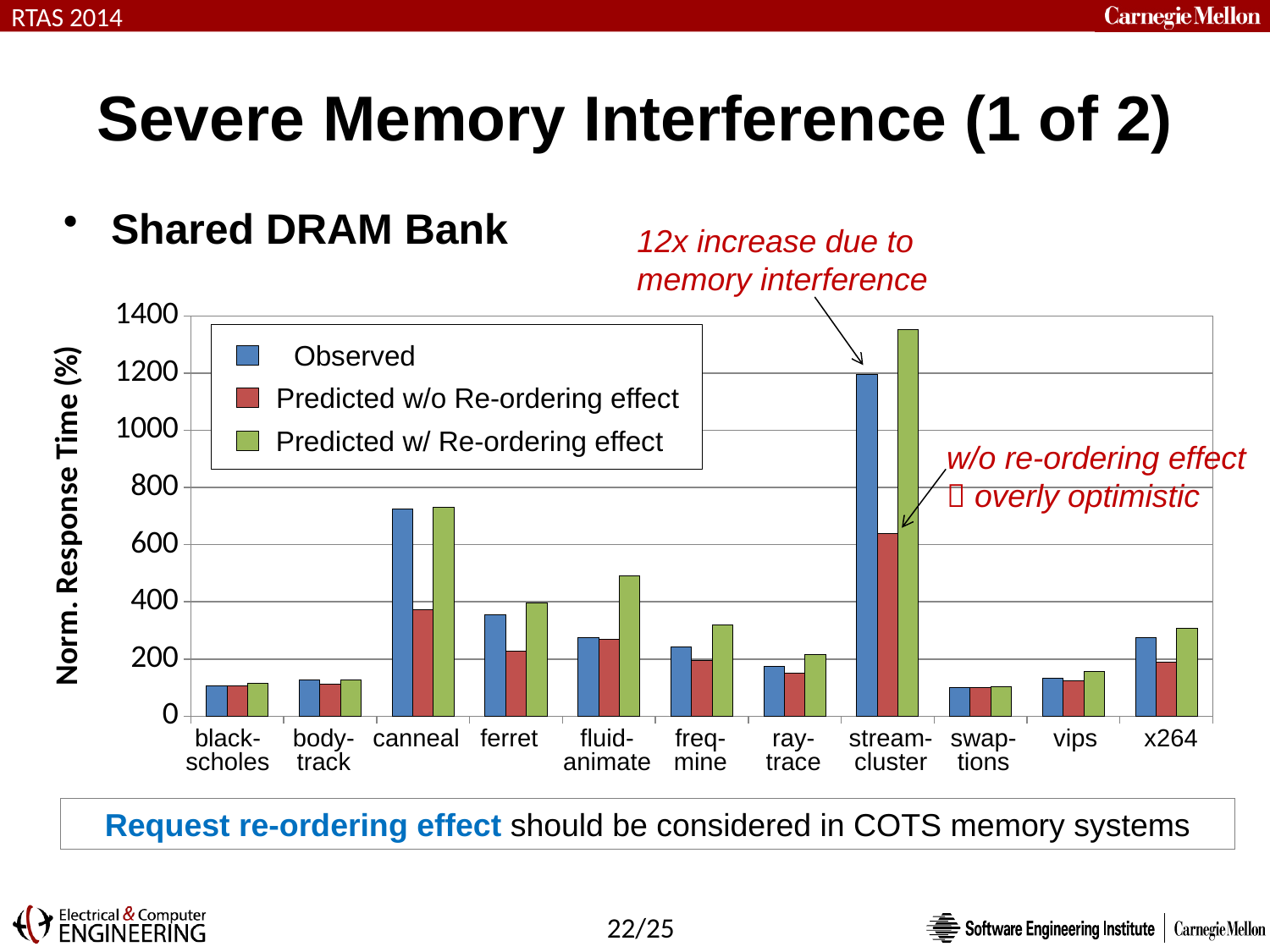
What kind of chart is shown on the slide? bar chart How many benchmark categories are shown on the x axis? 11 Which category has the highest Observed normalized response time? stream-cluster Is the Predicted w/ Re-ordering effect value for fluid-animate greater or less than 400? greater How many series does the legend list? 3 Is the Observed value for canneal greater or less than 600? greater For stream-cluster, which is larger: the Observed value or the Predicted w/o Re-ordering effect value? Observed For fluid-animate, which is larger: the Observed value or the Predicted w/ Re-ordering effect value? Predicted w/ Re-ordering effect Is the Observed value for stream-cluster greater or less than 1000? greater What is the label of the y axis? Norm. Response Time (%)